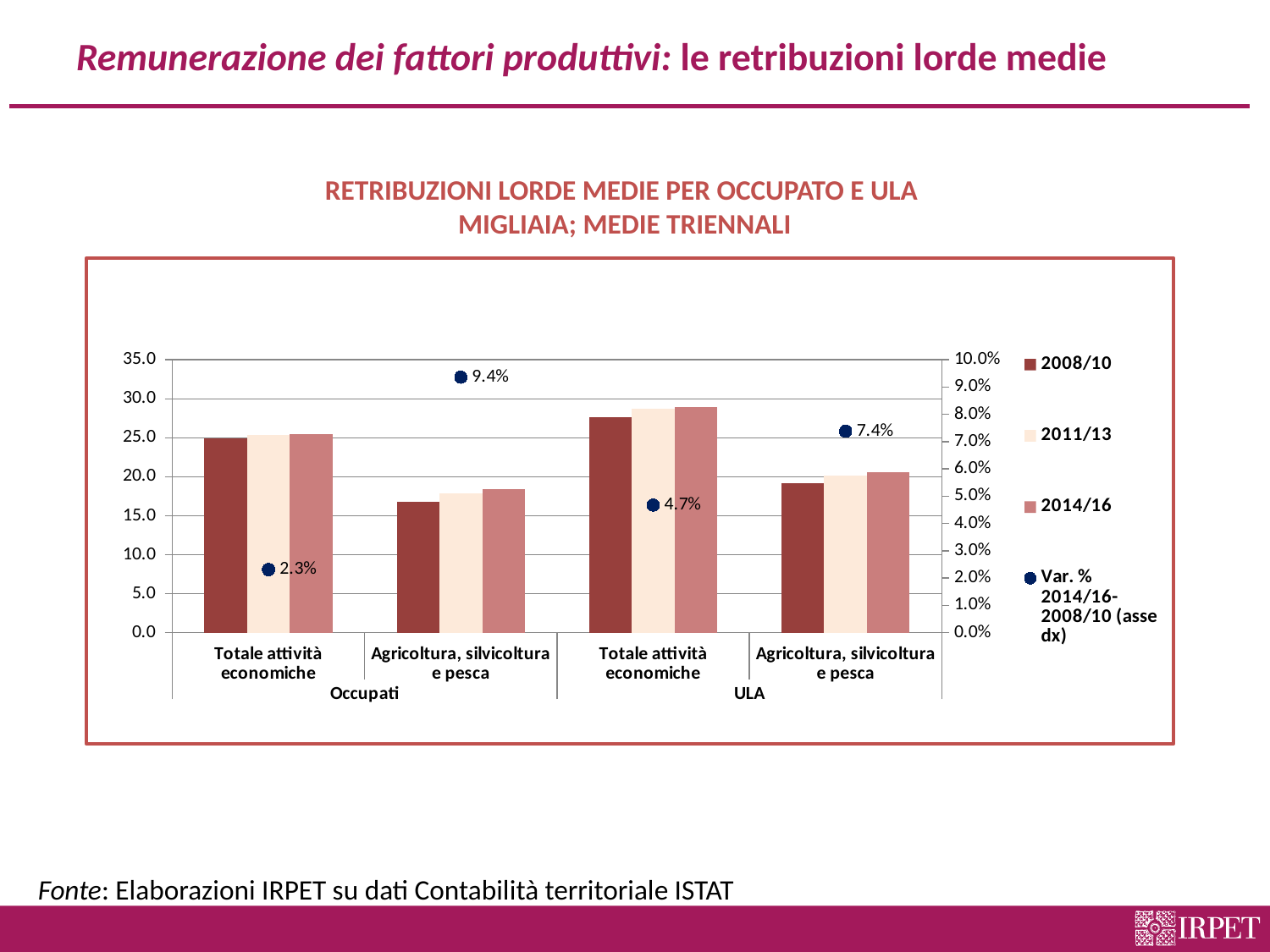
What is the Var. % 2014/16-2008/10 value for Agricoltura, silvicoltura e pesca under ULA? 7.4% What is the Var. % 2014/16-2008/10 value for Totale attività economiche under Occupati? 2.3% Is the 2014/16 bar for Totale attività economiche under ULA greater or less than 25.0? greater What is the Var. % 2014/16-2008/10 value for Agricoltura, silvicoltura e pesca under Occupati? 9.4% Is the 2008/10 bar for Agricoltura, silvicoltura e pesca under Occupati greater or less than 20.0? less What is the difference between the Var. % values for Agricoltura, silvicoltura e pesca (Occupati) and Totale attività economiche (Occupati)? 7.1 percentage points How many series does the legend list? 4 Which category has the highest Var. % 2014/16-2008/10 value? Agricoltura, silvicoltura e pesca (Occupati) Under ULA, which has the larger Var. % 2014/16-2008/10 value: Totale attività economiche or Agricoltura, silvicoltura e pesca? Agricoltura, silvicoltura e pesca Which category has the lowest Var. % 2014/16-2008/10 value? Totale attività economiche (Occupati) How many categories are shown on the x axis? 4 What is the Var. % 2014/16-2008/10 value for Totale attività economiche under ULA? 4.7%